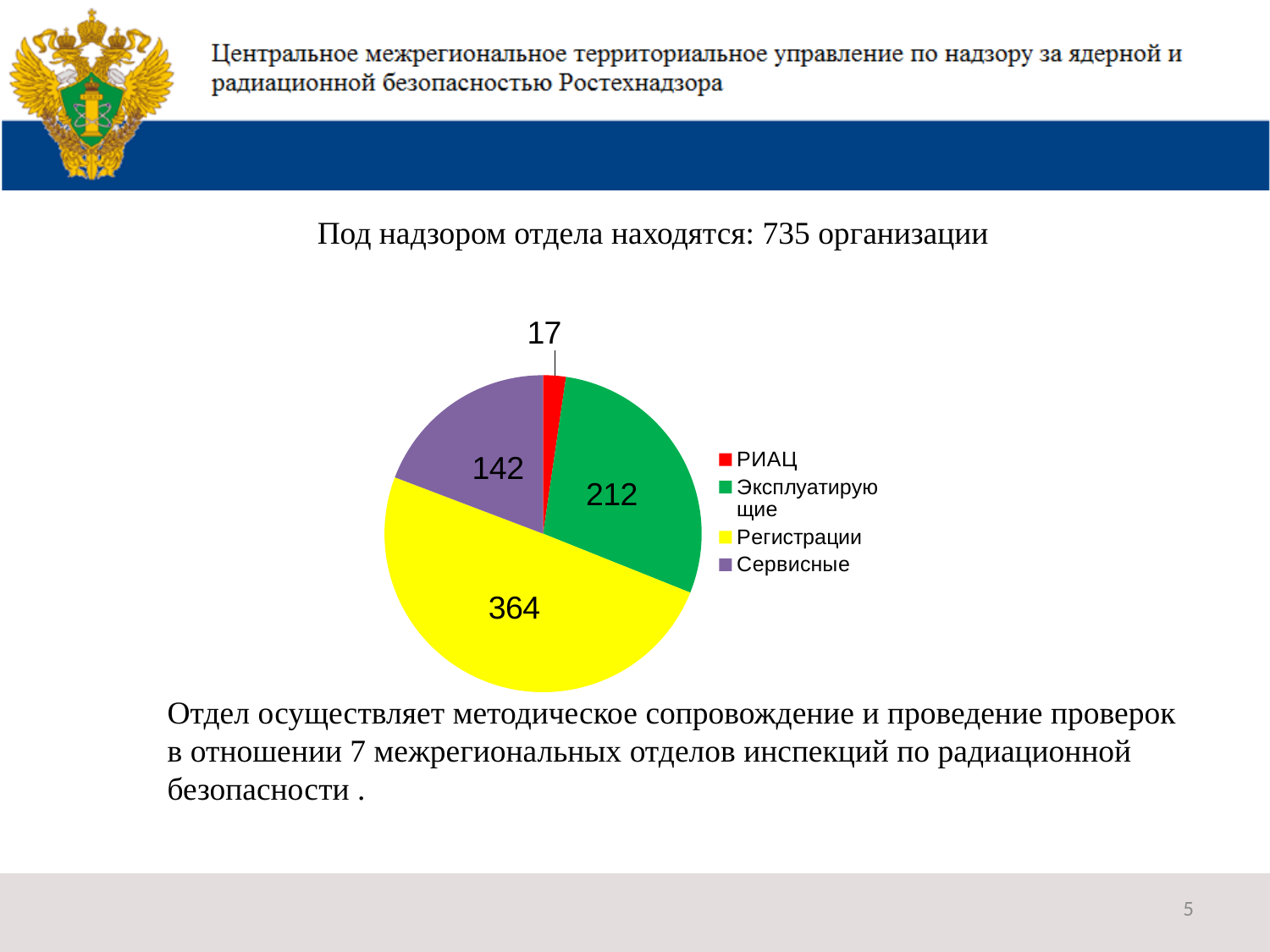
What is the value for Эксплуатирующие in the pie chart? 212 What type of chart is shown on the slide? Pie chart Which category has the smallest slice in the pie chart? РИАЦ Which category has the largest slice in the pie chart? Регистрации What is the total of all slices in the pie chart? 735 What is the value for Регистрации in the pie chart? 364 What is the difference between the values for Регистрации and Эксплуатирующие? 152 What colour is the slice for Регистрации? Yellow What is the value for РИАЦ in the pie chart? 17 What is the value for Сервисные in the pie chart? 142 Which is larger, the value for Эксплуатирующие or the value for Сервисные? Эксплуатирующие How many categories does the pie chart show? 4